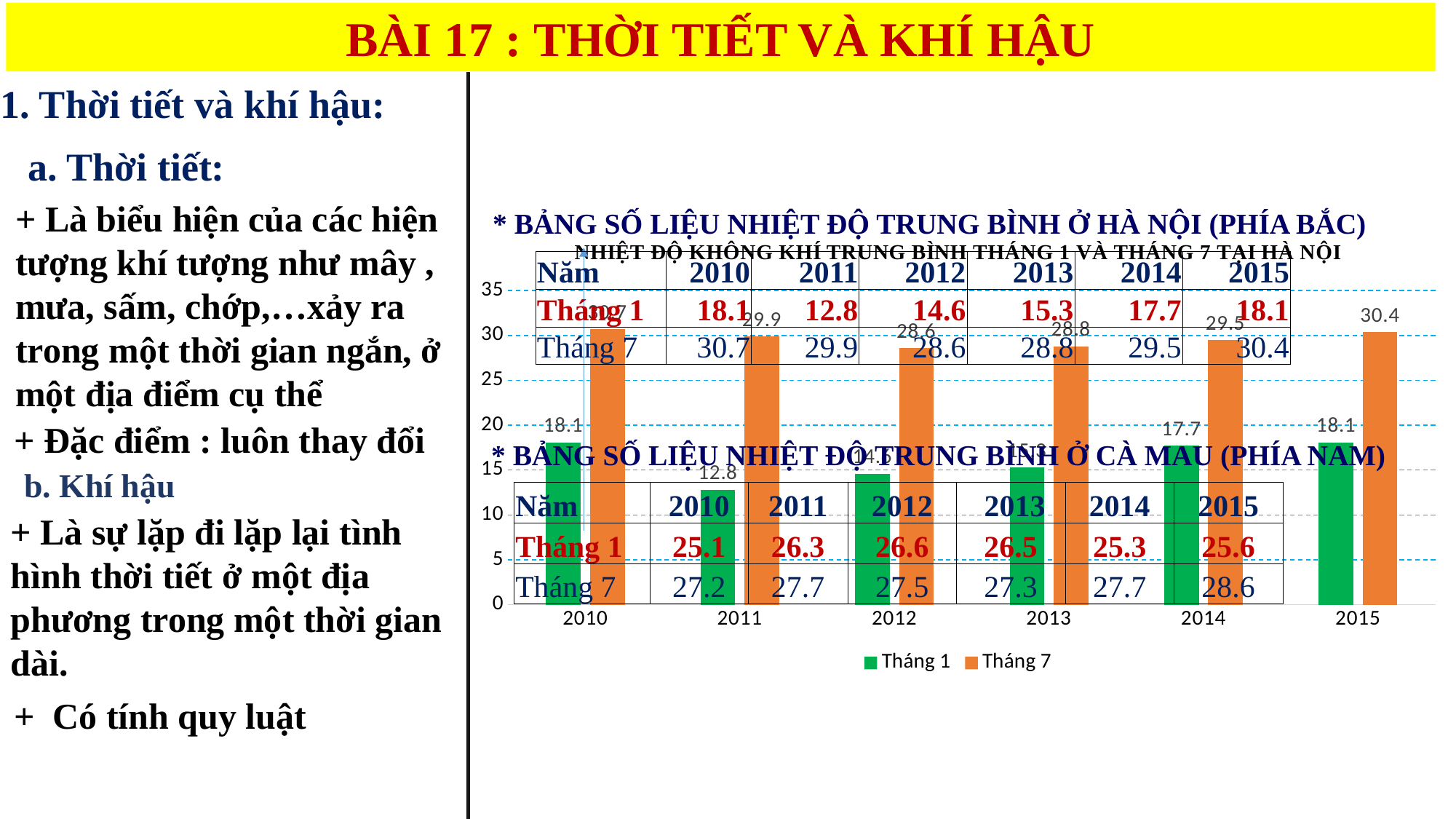
What kind of chart is shown on the slide? Bar chart How many series does the chart legend list? 2 Is the Tháng 7 value for 2013 greater or less than 25? greater In which year is the Tháng 1 value lowest? 2011 In which year is the Tháng 7 value highest? 2010 For 2012, which series has the larger value, Tháng 1 or Tháng 7? Tháng 7 What colour are the Tháng 7 bars in the chart? Orange What is the difference between the Tháng 7 and Tháng 1 values for 2014? 11.8 What is the Tháng 7 value for 2015 in the chart? 30.4 How many years are shown along the x axis of the chart? 6 Do the Tháng 1 values rise or fall from 2011 to 2015? Rise What is the Tháng 1 value for 2011 in the chart? 12.8